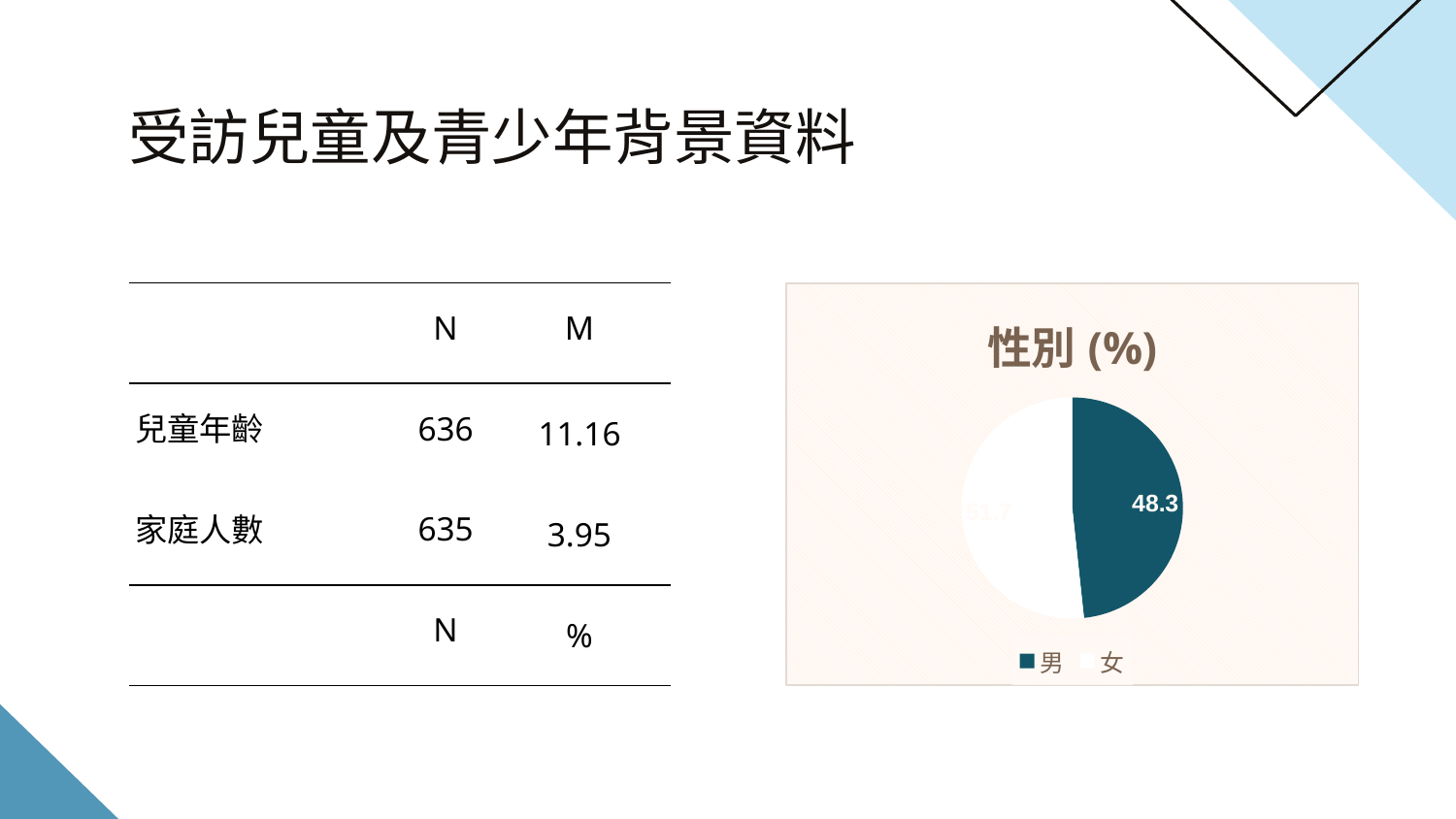
Which is larger in the pie chart, 男 or 女? 女 What is the value shown for 女 in the pie chart? 51.7 What colour is the 男 slice in the pie chart? dark teal What is the title of the pie chart? 性別 (%) Which category has the smaller share of the pie chart? 男 Is the value for 男 in the pie chart greater or less than 50? less What is the difference between the 女 and 男 values in the pie chart? 3.4 Which category has the larger share of the pie chart? 女 How many entries does the pie chart's legend list? 2 What kind of chart is shown on the slide? pie chart What is the value shown for 男 in the pie chart? 48.3 How many slices does the pie chart have? 2